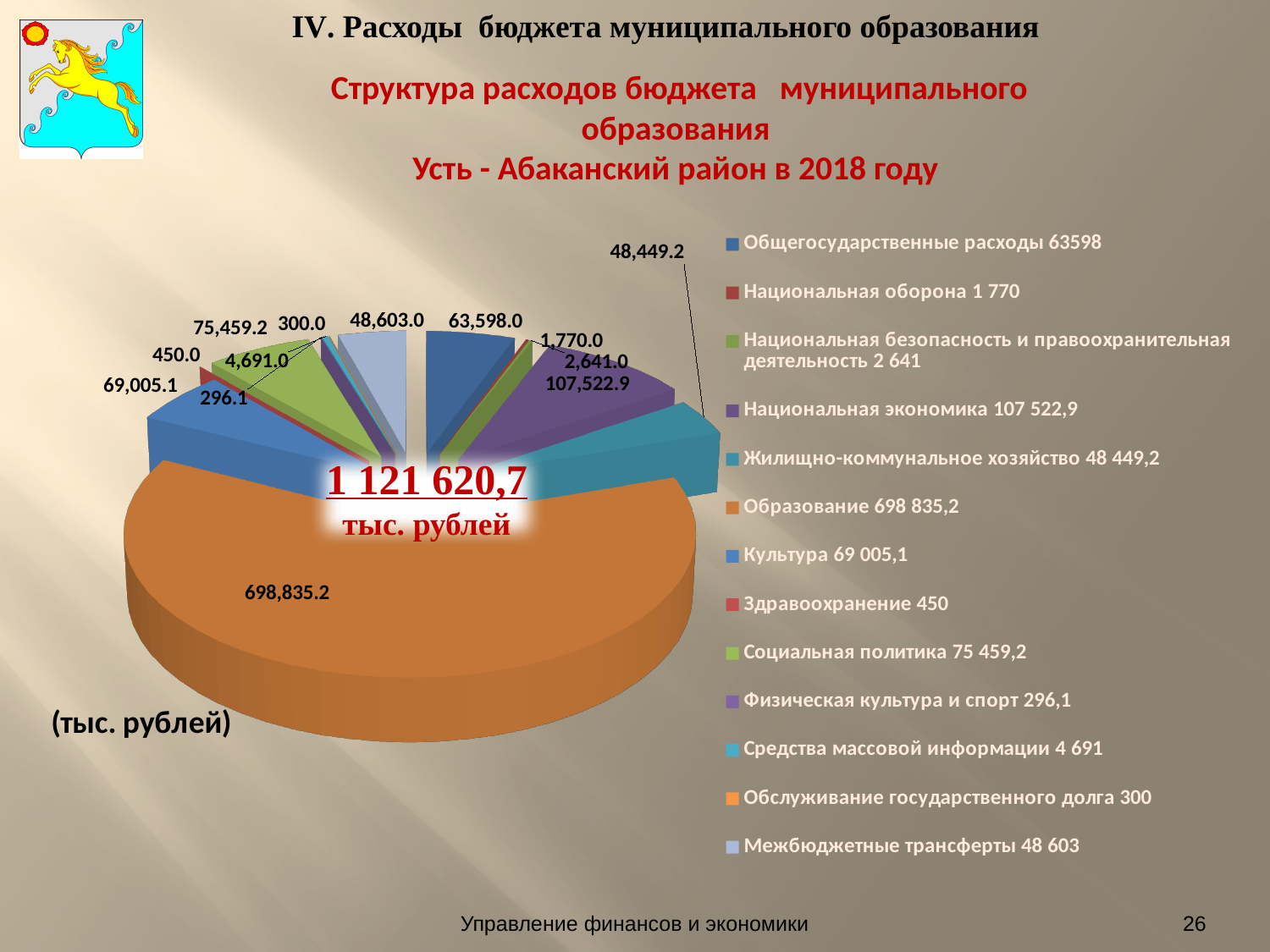
What total amount is printed in the centre of the pie chart? 1 121 620,7 тыс. рублей What is the value shown for Образование on the pie chart? 698,835.2 What is the difference between the values for Национальная экономика and Жилищно-коммунальное хозяйство on the pie chart? 59,073.7 What is the difference between the values for Социальная политика and Культура on the pie chart? 6,454.1 What is the value shown for Жилищно-коммунальное хозяйство on the pie chart? 48,449.2 How many categories does the pie chart's legend list? 13 Which category has the smallest value on the pie chart? Физическая культура и спорт Which category has the largest slice of the pie chart? Образование Which is larger on the pie chart, Культура or Социальная политика? Социальная политика What is the value shown for Здравоохранение on the pie chart? 450.0 What is the value shown for Национальная экономика on the pie chart? 107,522.9 What kind of chart is shown on the slide? pie chart